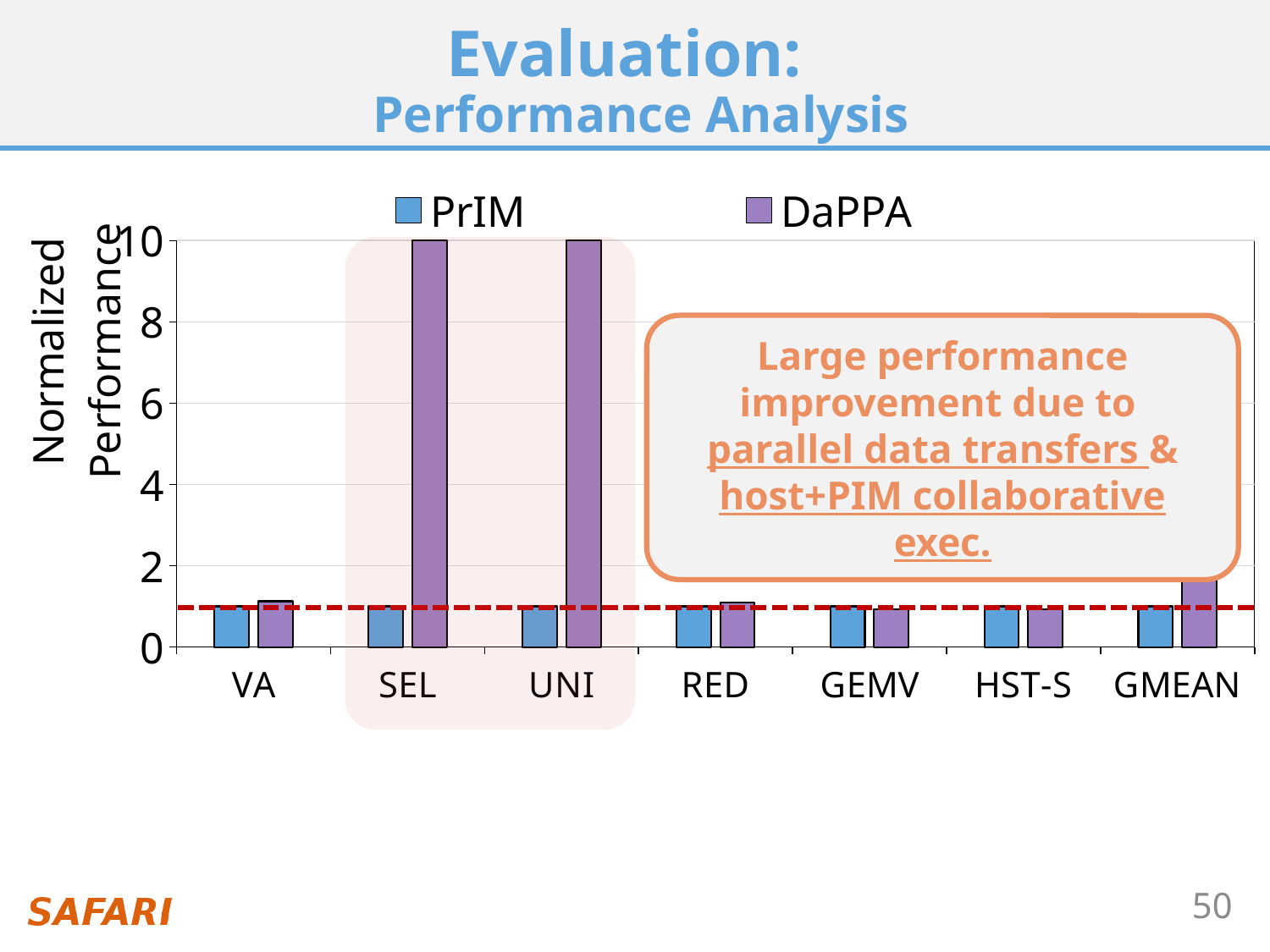
What is the label of the y axis? Normalized Performance Which is larger, the DaPPA value for UNI or the PrIM value for UNI? DaPPA How many categories are shown along the x axis? 7 Which two series are listed in the legend? PrIM and DaPPA Is the DaPPA value for UNI greater or less than 6? greater How many series does the legend list? 2 Is the DaPPA value for GMEAN greater or less than 4? less Which is larger, the DaPPA value for SEL or the DaPPA value for RED? SEL Is the DaPPA value for VA greater or less than 2? less What kind of chart is shown on the slide? bar chart